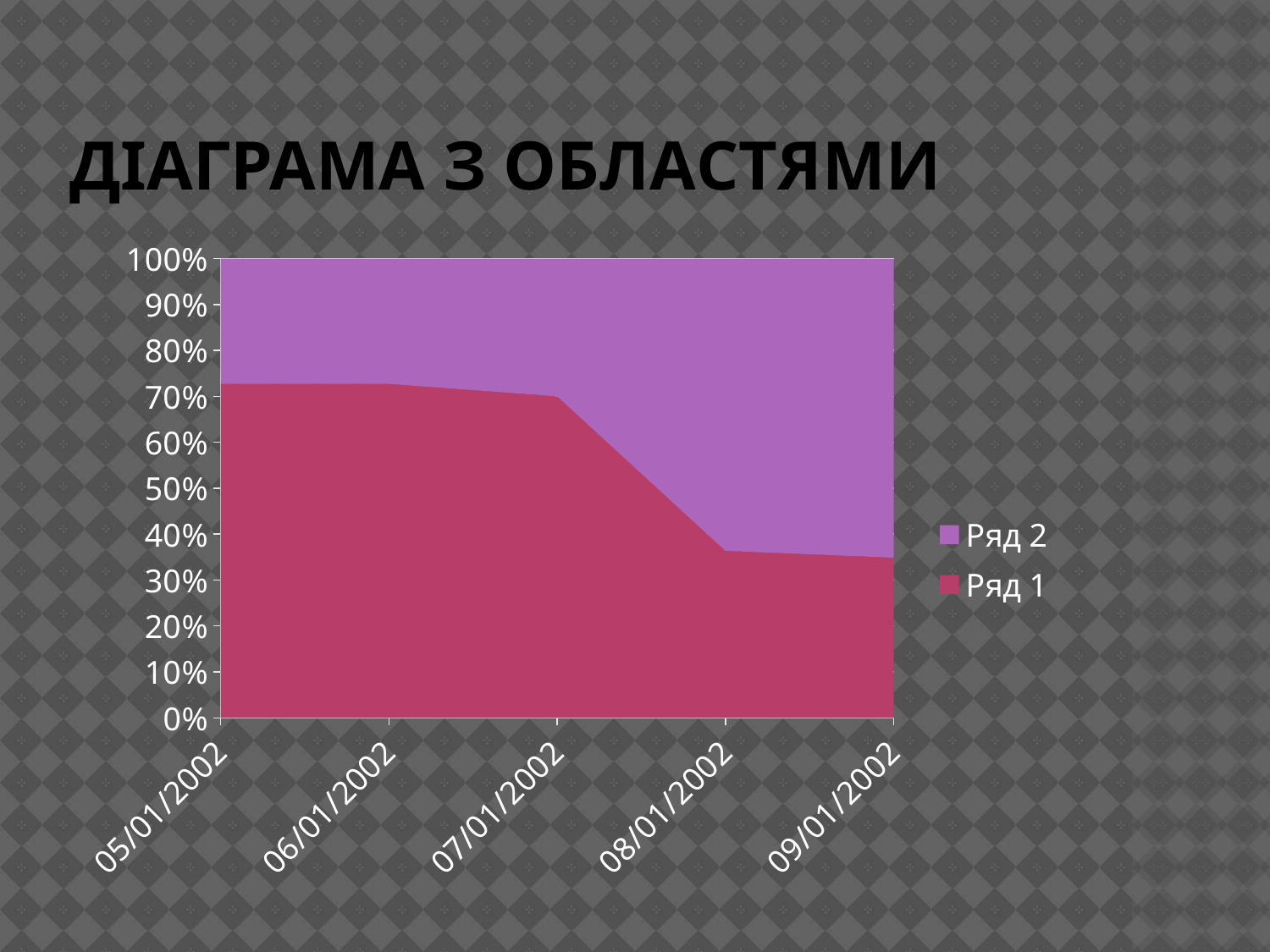
What kind of chart is shown on the slide? Area chart How many series does the legend list? 2 At 09/01/2002, which series has the larger share, Ряд 1 or Ряд 2? Ряд 2 Does the share of Ряд 2 rise or fall from 05/01/2002 to 09/01/2002? Rise Is the share of Ряд 1 at 05/01/2002 greater or less than 60%? greater Is the share of Ряд 1 at 08/01/2002 greater or less than 40%? less Is the share of Ряд 1 at 09/01/2002 greater or less than 50%? less What are the names of the two series in the legend? Ряд 1 and Ряд 2 What is the title of the chart? ДІАГРАМА З ОБЛАСТЯМИ How many dates are shown on the x axis? 5 At 05/01/2002, which series has the larger share, Ряд 1 or Ряд 2? Ряд 1 Does the share of Ряд 1 rise or fall from 05/01/2002 to 09/01/2002? Fall